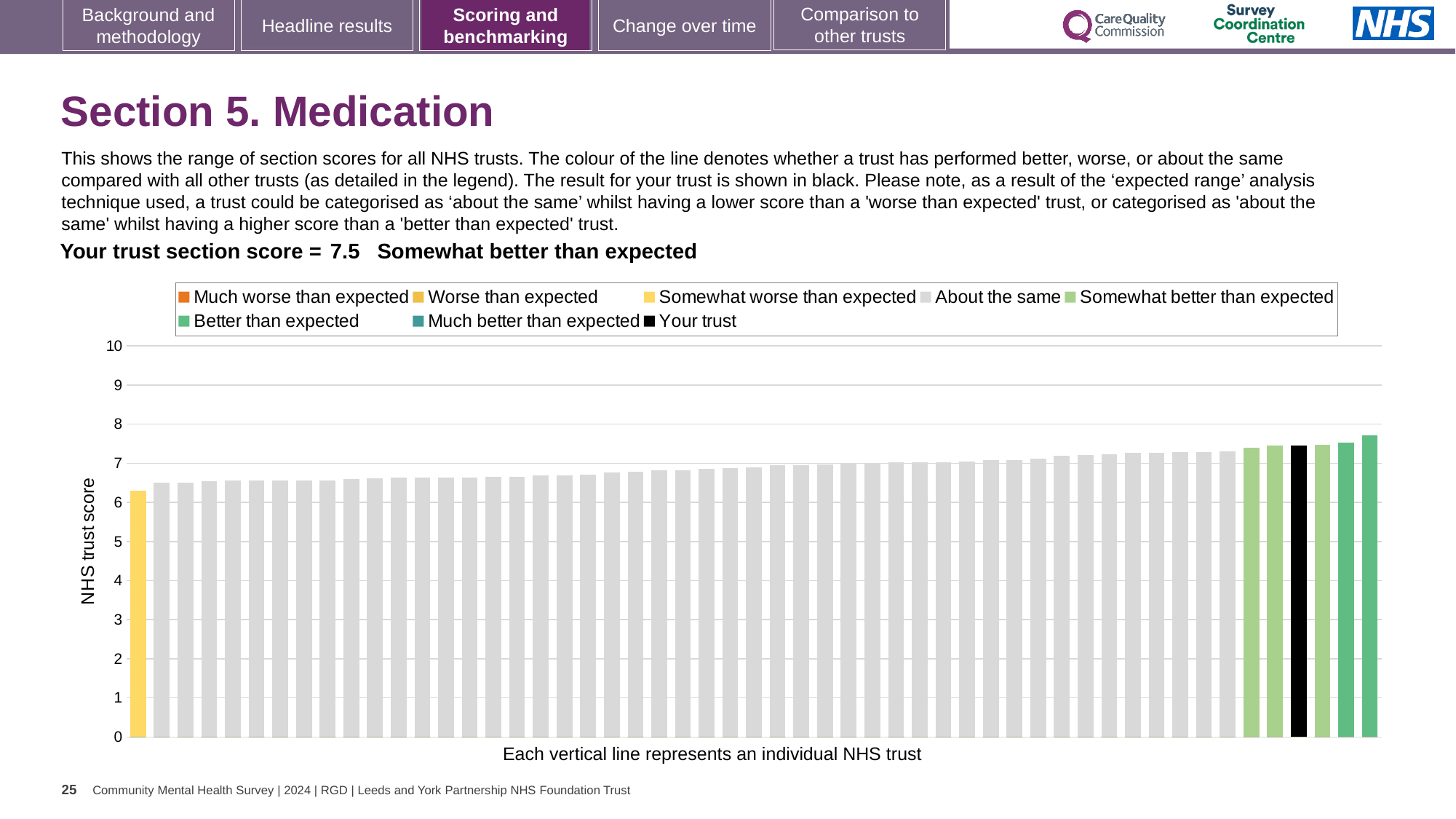
What is the trust's section score for Medication shown on the slide? 7.5 Is the value of the highest (rightmost) bar greater or less than 8? less Is the value of the highest (rightmost) bar greater or less than 7? greater Is the value of the lowest (leftmost, yellow) bar greater or less than 7? less Which legend category does the highest bar on the chart belong to? Better than expected Which is larger: the score for your trust (black bar) or the score of the leftmost yellow bar? your trust What is the label on the vertical axis of the chart? NHS trust score Do the bar values rise or fall moving from left to right along the x axis? rise Which colour is used for the bar representing your trust? black What kind of chart is shown on the slide? bar chart How many entries does the chart legend list? 8